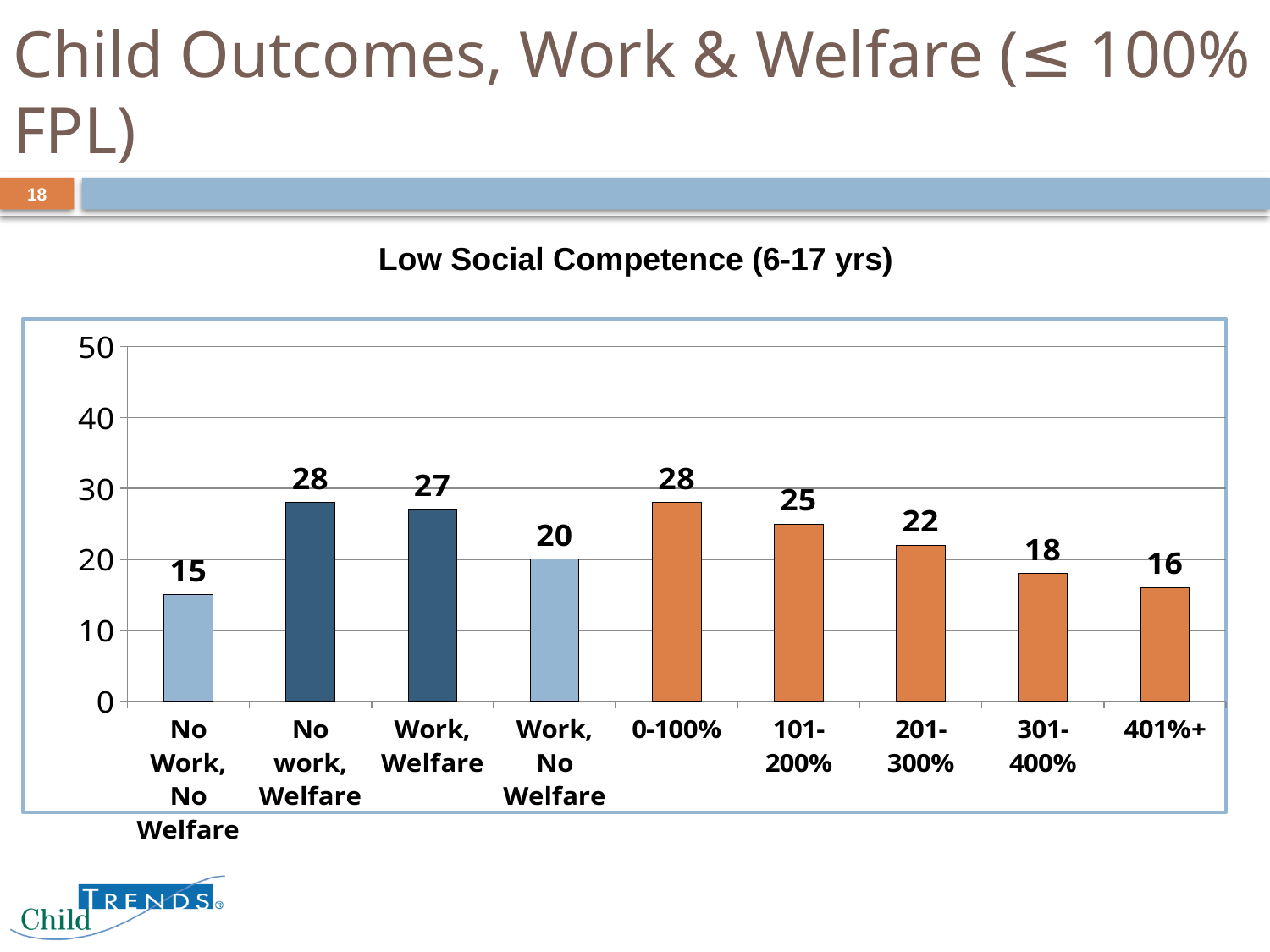
Which is larger, the value for 'Work, Welfare' or the value for 'Work, No Welfare'? Work, Welfare Which category has the lowest value? No Work, No Welfare What is the difference between the values for '0-100%' and '401%+'? 12 How many categories are shown on the x axis? 9 What is the value for the 'Work, No Welfare' category? 20 What kind of chart is shown on the slide? Bar chart What is the value for the '301-400%' category? 18 What is the value for the 'No Work, No Welfare' category? 15 What is the value for the '0-100%' category? 28 Do the values rise or fall across the income categories from '0-100%' to '401%+'? Fall What is the difference between the values for 'No work, Welfare' and 'No Work, No Welfare'? 13 Is the value for '101-200%' greater or less than 20? greater